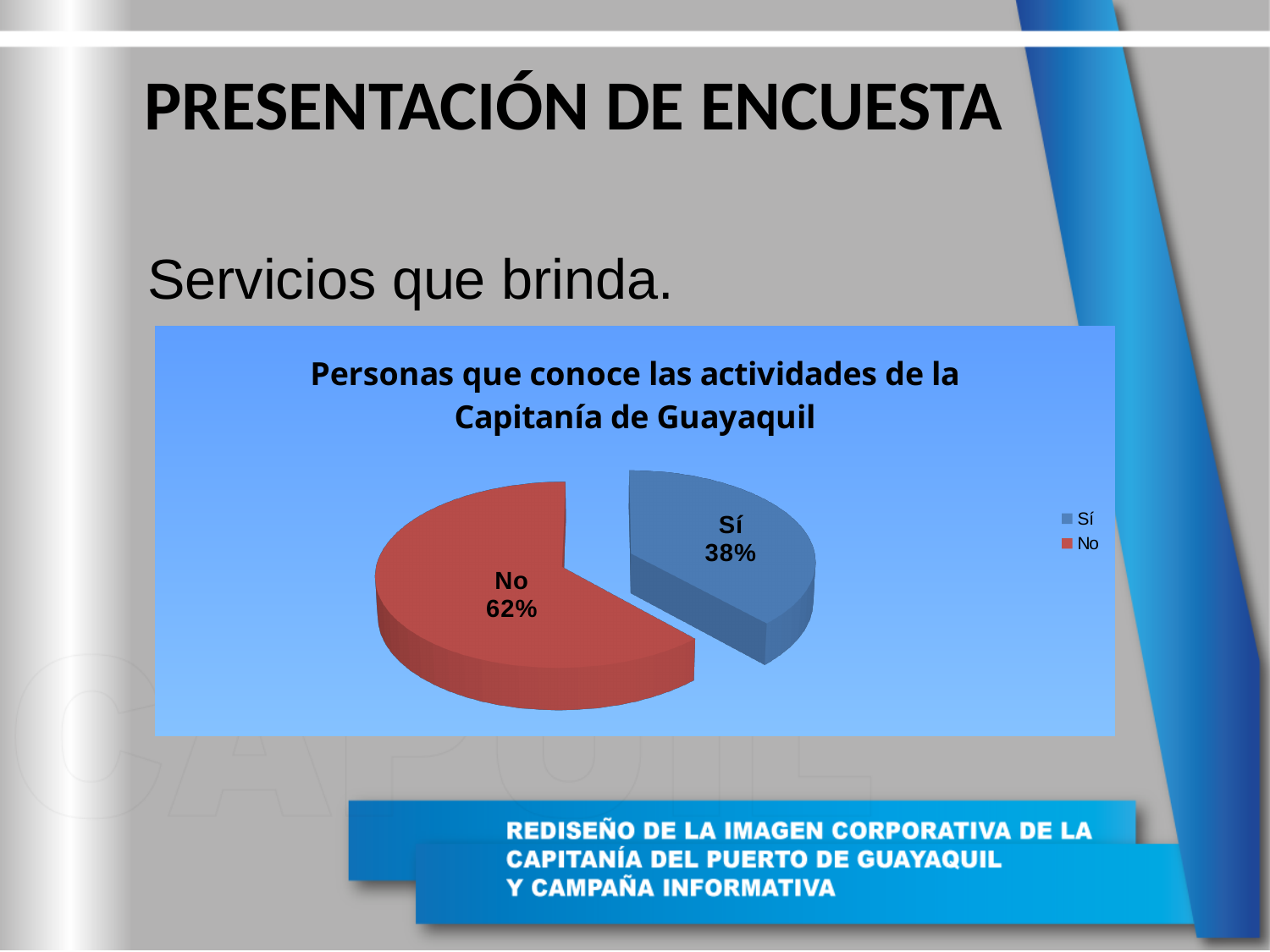
How many entries does the legend list? 2 Which slice of the pie is the smallest? Sí What is the difference in percentage points between the "No" slice and the "Sí" slice? 24 What percentage of the pie corresponds to "Sí"? 38% Which is larger, the "Sí" slice or the "No" slice? No What percentage of the pie corresponds to "No"? 62% How many slices does the pie chart have? 2 What share of the pie does the "Sí" slice represent? 38% What is the title of the chart? Personas que conoce las actividades de la Capitanía de Guayaquil What colour is the "No" slice in the pie chart? red What kind of chart is shown on the slide? pie chart Which slice of the pie is the largest? No